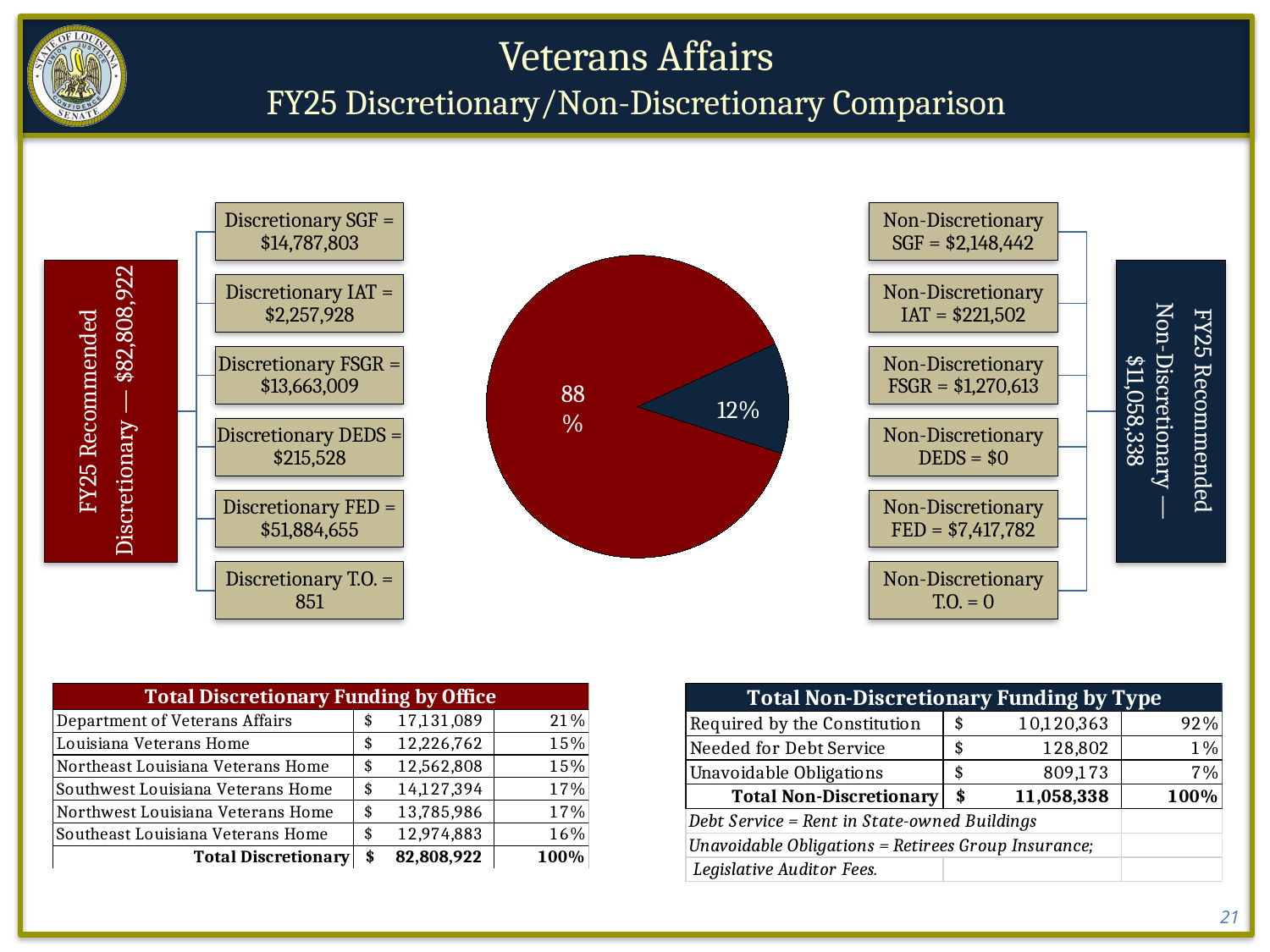
What percentage is shown on the smaller slice of the pie chart? 12% In the pie chart, which slice is larger, the dark red one or the dark blue one? dark red How many slices does the pie chart have? 2 What kind of chart is shown in the centre of the slide? pie chart What colour is the slice labelled 12% in the pie chart? dark blue What is the difference in percentage points between the two slices of the pie chart? 76 What colour is the slice labelled 88% in the pie chart? dark red Is the share shown on the smaller slice of the pie chart greater or less than 50%? less Do the two slices of the pie chart add up to 100%? yes What percentage is shown on the larger slice of the pie chart? 88%